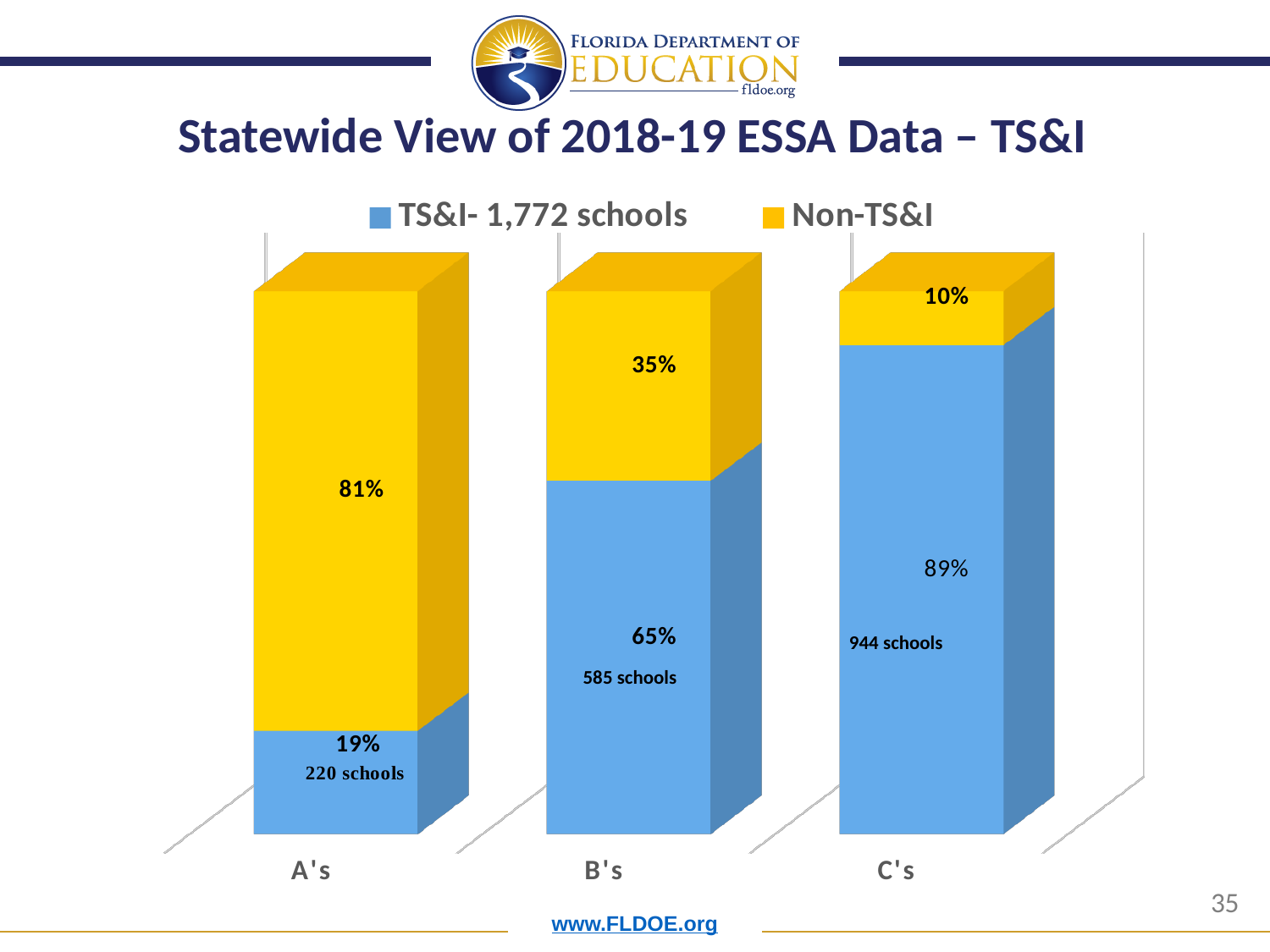
Which is larger for B's: the TS&I percentage or the Non-TS&I percentage? TS&I What percentage of A's schools are TS&I? 19% What percentage of C's schools are TS&I? 89% Which grade category has the highest TS&I percentage? C's How many C's schools are TS&I? 944 schools How many series does the legend list? 2 Which grade category has the lowest Non-TS&I percentage? C's What is the difference between the Non-TS&I percentage and the TS&I percentage for A's? 62% What percentage of B's schools are Non-TS&I? 35% What kind of chart is shown on the slide? Stacked bar chart How many A's schools are TS&I? 220 schools How many grade categories are shown on the x axis? 3